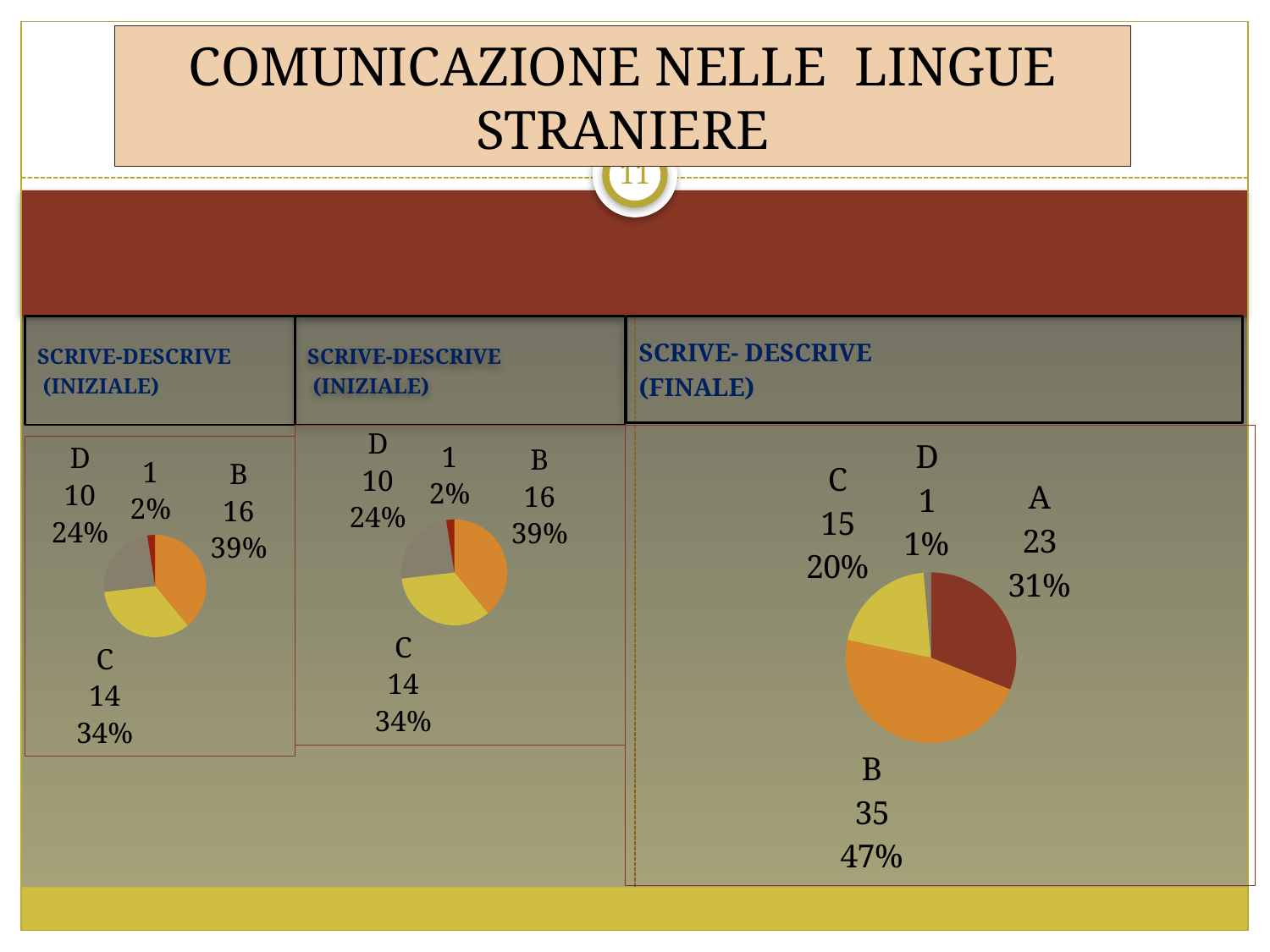
In the rightmost chart (SCRIVE- DESCRIVE (FINALE)), which category has the smallest slice? D In the leftmost chart (SCRIVE-DESCRIVE (INIZIALE)), what is the value for B? 16 What kind of chart is the rightmost chart titled SCRIVE- DESCRIVE (FINALE)? pie chart In the middle chart (SCRIVE-DESCRIVE (INIZIALE)), what is the value for D? 10 In the rightmost chart (SCRIVE- DESCRIVE (FINALE)), which category has the largest slice? B In the rightmost chart (SCRIVE- DESCRIVE (FINALE)), what share of the pie does B represent? 47% In the rightmost chart (SCRIVE- DESCRIVE (FINALE)), which is larger, the value for C or the value for A? A In the rightmost chart (SCRIVE- DESCRIVE (FINALE)), what is the value for A? 23 In the rightmost chart (SCRIVE- DESCRIVE (FINALE)), what is the value for B? 35 How many slices does the rightmost chart (SCRIVE- DESCRIVE (FINALE)) have? 4 In the leftmost chart (SCRIVE-DESCRIVE (INIZIALE)), what share of the pie does C represent? 34% In the rightmost chart (SCRIVE- DESCRIVE (FINALE)), what is the difference between the values for B and A? 12